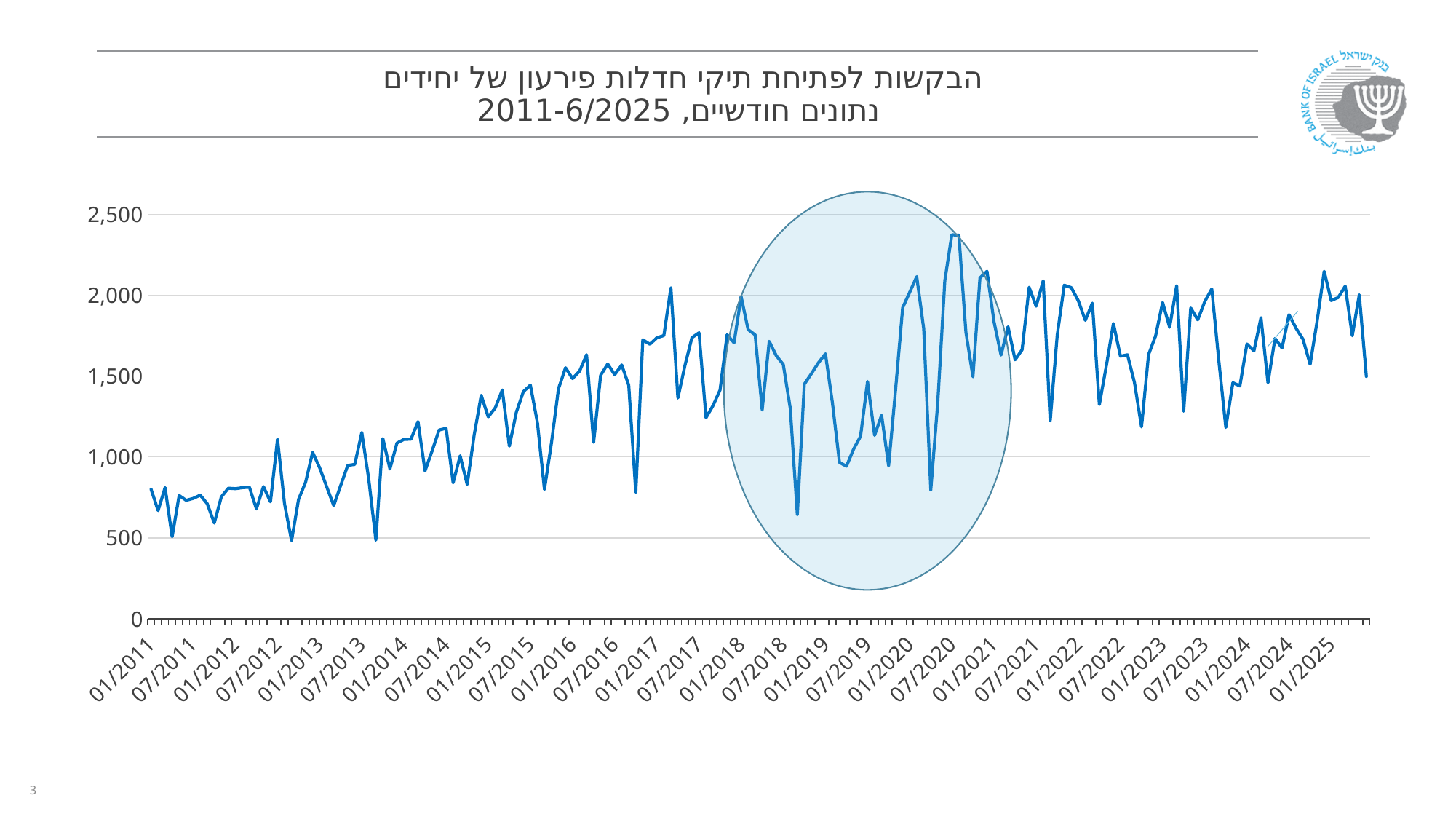
Is the highest peak of the line greater or less than 2,000? greater Is the value for 01/2025 greater or less than 1,500? greater What kind of chart is shown on the slide? Line chart Which is larger, the value for 01/2011 or the value for 01/2025? 01/2025 What period does the chart title say the monthly data covers? 2011-6/2025 Overall, do the values rise or fall from 01/2011 to 2025? Rise Is the value for 01/2012 greater or less than 1,000? less What is the highest value shown on the vertical axis? 2,500 In which year does the line reach its highest point? 2020 How many data series (lines) are plotted on the chart? 1